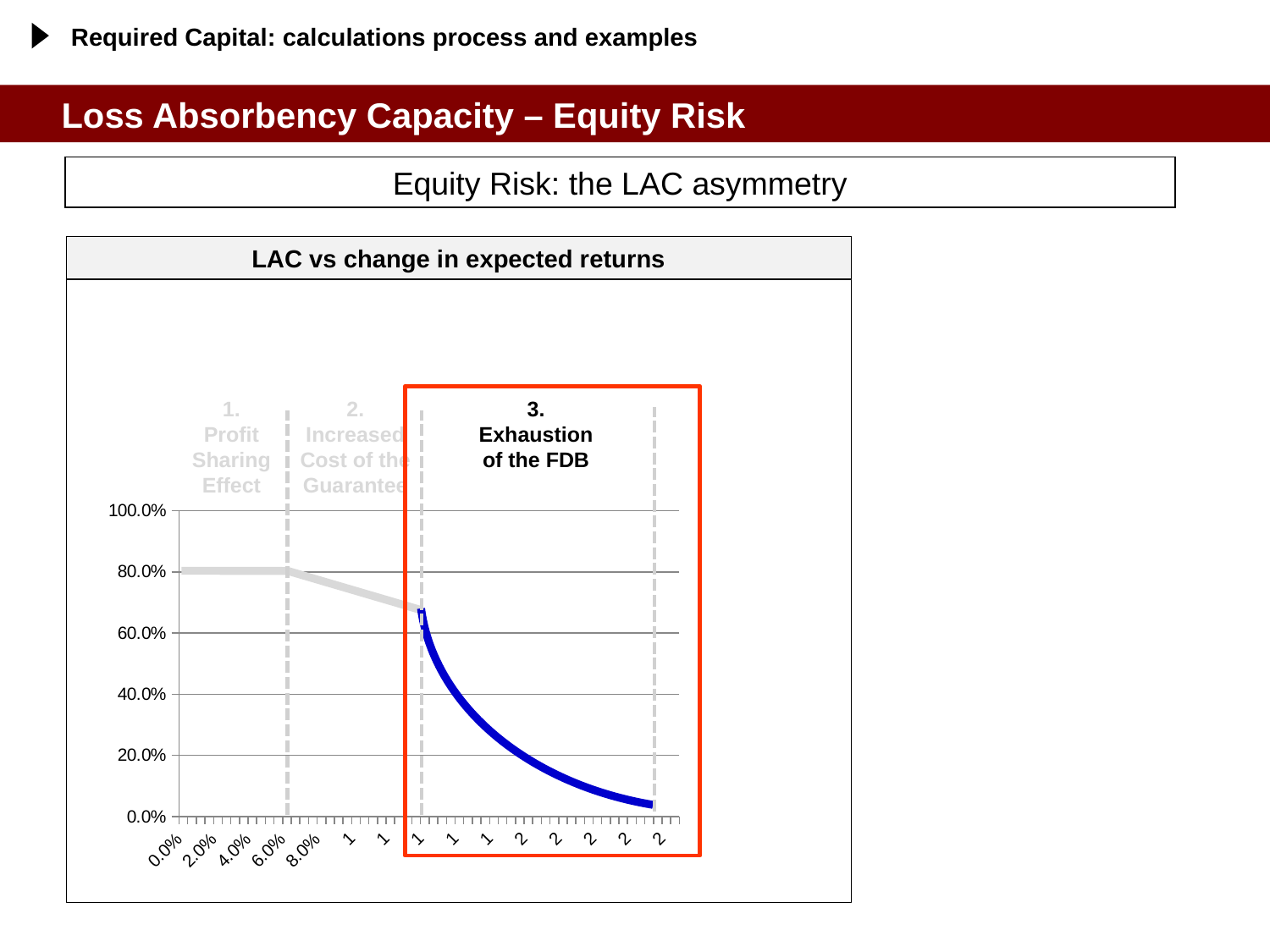
Is the value at 2.0% on the x axis greater or less than 100%? less Is the value at 8.0% on the x axis greater or less than 40%? greater Is the value at the right-hand end of the blue line greater or less than 20%? less How many labelled regions does the chart divide the x axis into? 3 What is the label of the third region, highlighted with the red box? 3. Exhaustion of the FDB Do the plotted values rise or fall as you move from left to right along the x axis? fall Which is larger, the value at 0.0% or the value at the right-hand end of the blue line? the value at 0.0% What is the highest value shown on the y axis? 100.0% What is the title of the chart? LAC vs change in expected returns What kind of chart is shown on the slide? line chart